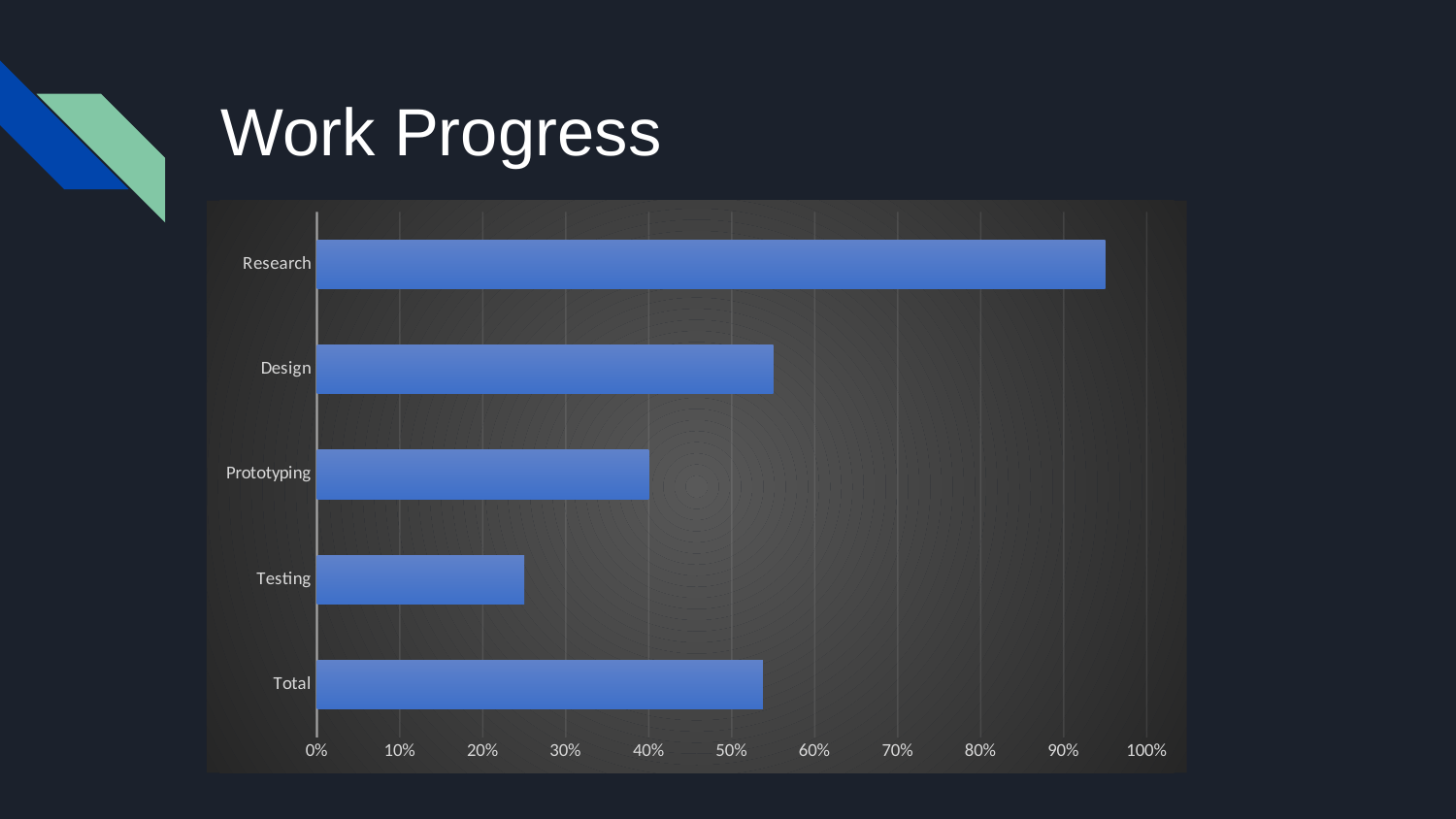
Is the value for Research greater or less than 90%? greater What is the title of the slide containing the chart? Work Progress Is the value for Testing greater or less than 30%? less How many categories are plotted in the chart? 5 Which category has the highest value? Research Which category has the lowest value? Testing Which is larger, the value for Prototyping or the value for Testing? Prototyping Is the value for Prototyping greater or less than 50%? less Which is larger, the value for Research or the value for Design? Research What kind of chart is shown on the slide? bar chart